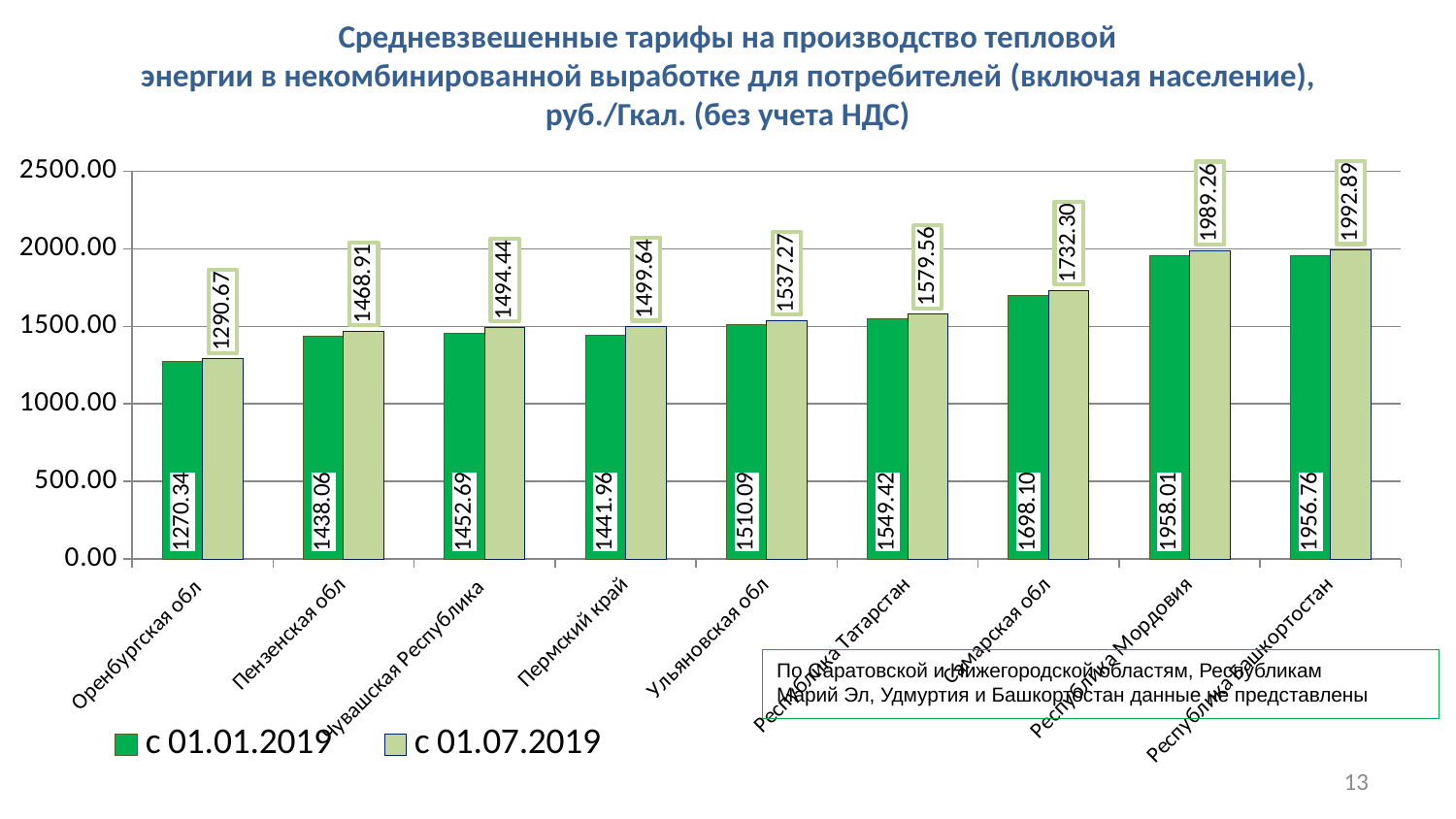
What is the difference between the с 01.07.2019 and с 01.01.2019 values for Самарская обл? 34.20 What is the difference between the с 01.07.2019 and с 01.01.2019 values for Пермский край? 57.68 How many regions are shown on the x axis? 9 How many series does the legend list? 2 What is the value for Республика Татарстан in the с 01.07.2019 series? 1579.56 Which region has the lowest value in the с 01.01.2019 series? Оренбургская обл Which is larger: the с 01.01.2019 value for Чувашская Республика or the с 01.01.2019 value for Пермский край? Чувашская Республика What is the value for Ульяновская обл in the с 01.01.2019 series? 1510.09 What is the value for Пензенская обл in the с 01.07.2019 series? 1468.91 Which region has the highest value in the с 01.07.2019 series? Республика Башкортостан What kind of chart is shown on the slide? Bar chart Do the с 01.07.2019 values generally rise or fall from left to right along the x axis? Rise